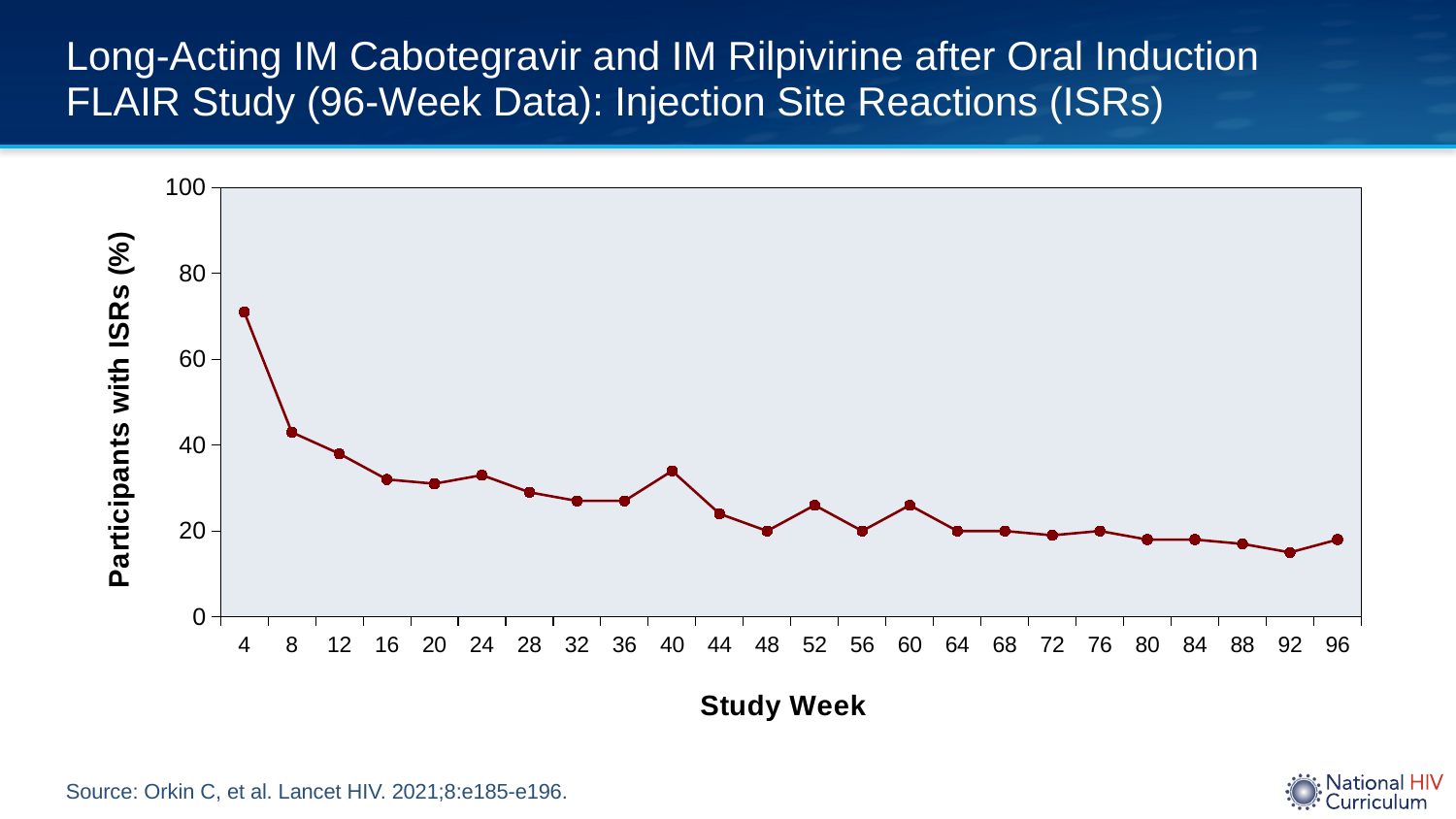
At which study week is the percentage of participants with ISRs lowest? Week 92 How many study-week data points are plotted on the chart? 24 Is the value for week 4 greater or less than 60? greater Overall, does the percentage of participants with ISRs rise or fall from week 4 to week 96? Fall What kind of chart is shown on the slide? Line chart What is the label of the y-axis? Participants with ISRs (%) Is the value for week 16 greater or less than 40? less Is the value for week 92 greater or less than 20? less Which has a higher percentage of participants with ISRs, week 40 or week 44? Week 40 At which study week is the percentage of participants with ISRs highest? Week 4